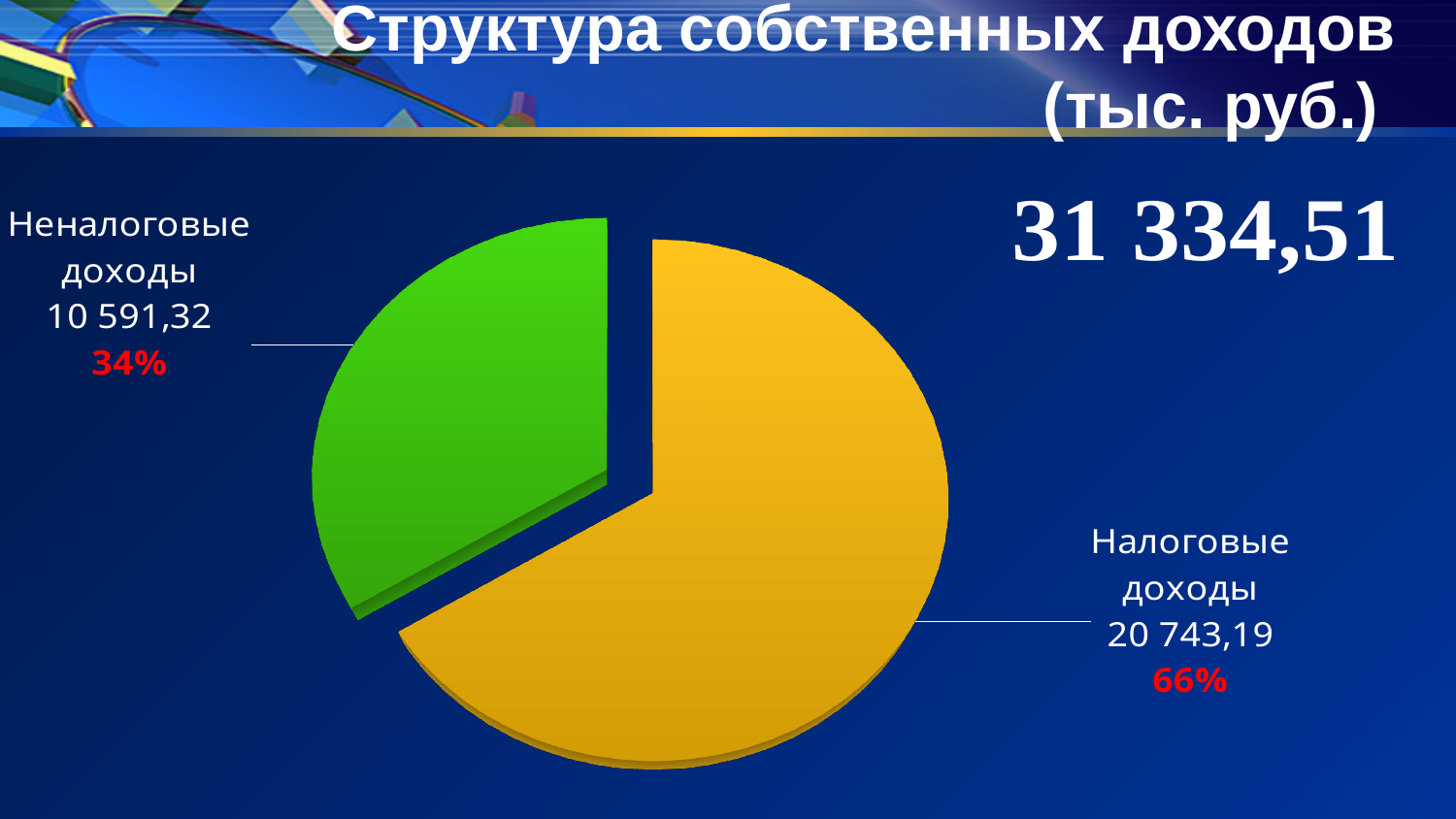
Which category has the largest slice of the pie? Налоговые доходы What is the total of all slices shown on the slide? 31 334,51 Which category has the smallest slice of the pie? Неналоговые доходы How many slices does the pie chart have? 2 What is the title of the chart? Структура собственных доходов (тыс. руб.) What share of the pie does Налоговые доходы represent? 66% What is the value for Налоговые доходы? 20 743,19 What share of the pie does Неналоговые доходы represent? 34% Which is larger, Налоговые доходы or Неналоговые доходы? Налоговые доходы What is the difference between the values for Налоговые доходы and Неналоговые доходы? 10 151,87 What is the value for Неналоговые доходы? 10 591,32 What kind of chart is shown on the slide? pie chart